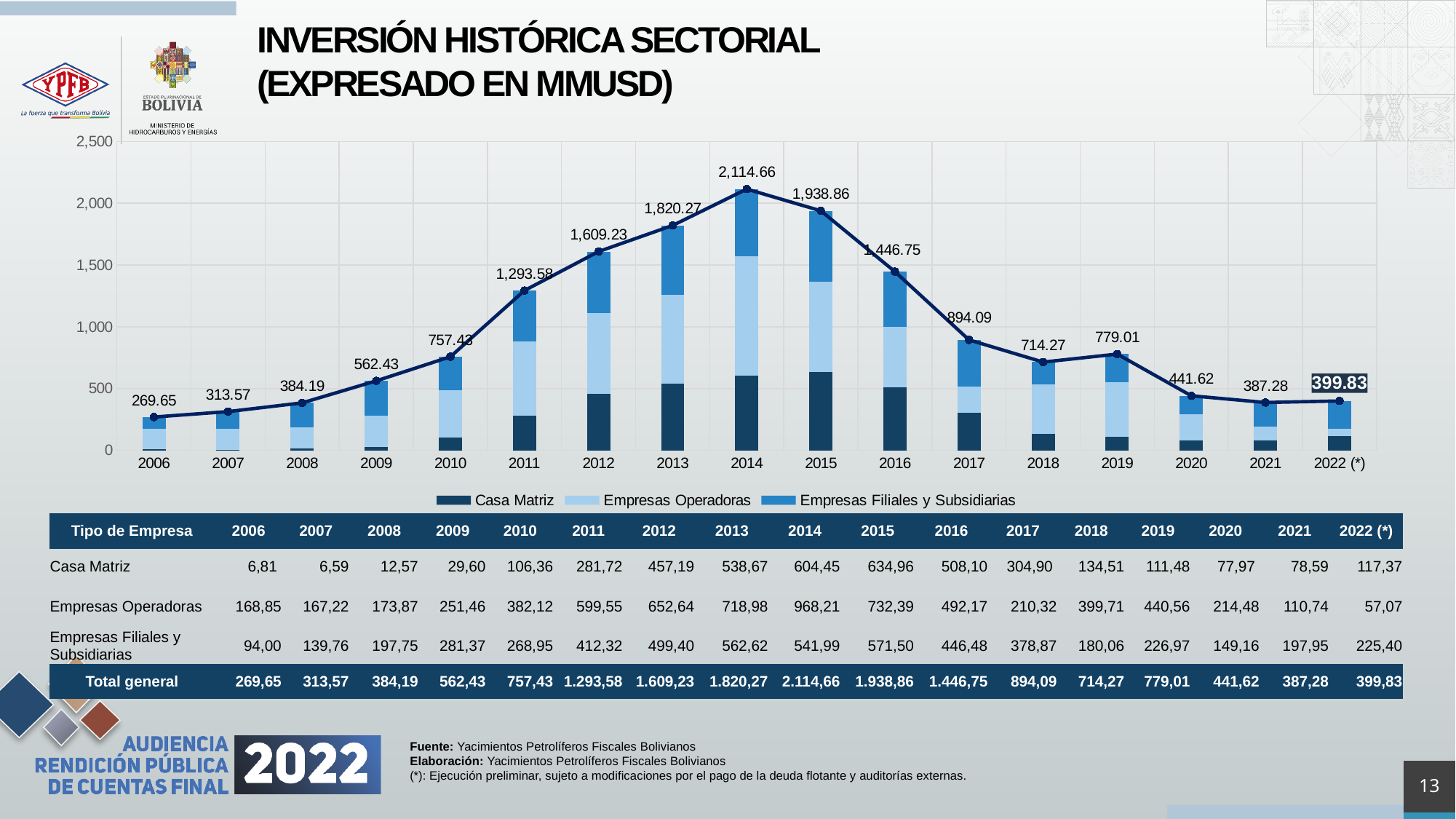
What is the difference between the total investment in 2014 and in 2015? 175.80 How many series does the chart legend list? 3 Which year has a larger total investment, 2018 or 2019? 2019 Is the total investment for 2011 greater or less than 1,000? greater Which year has the lowest total investment? 2006 Do the total investment values rise or fall from 2006 to 2014? Rise How many years are shown on the x axis of the chart? 17 What is the total investment shown for 2014? 2,114.66 What kind of chart is shown on the slide? Stacked bar chart with a line Which year has the highest total investment? 2014 What is the total investment shown for 2022 (*)? 399.83 According to the table, what is the Casa Matriz value for 2015? 634,96